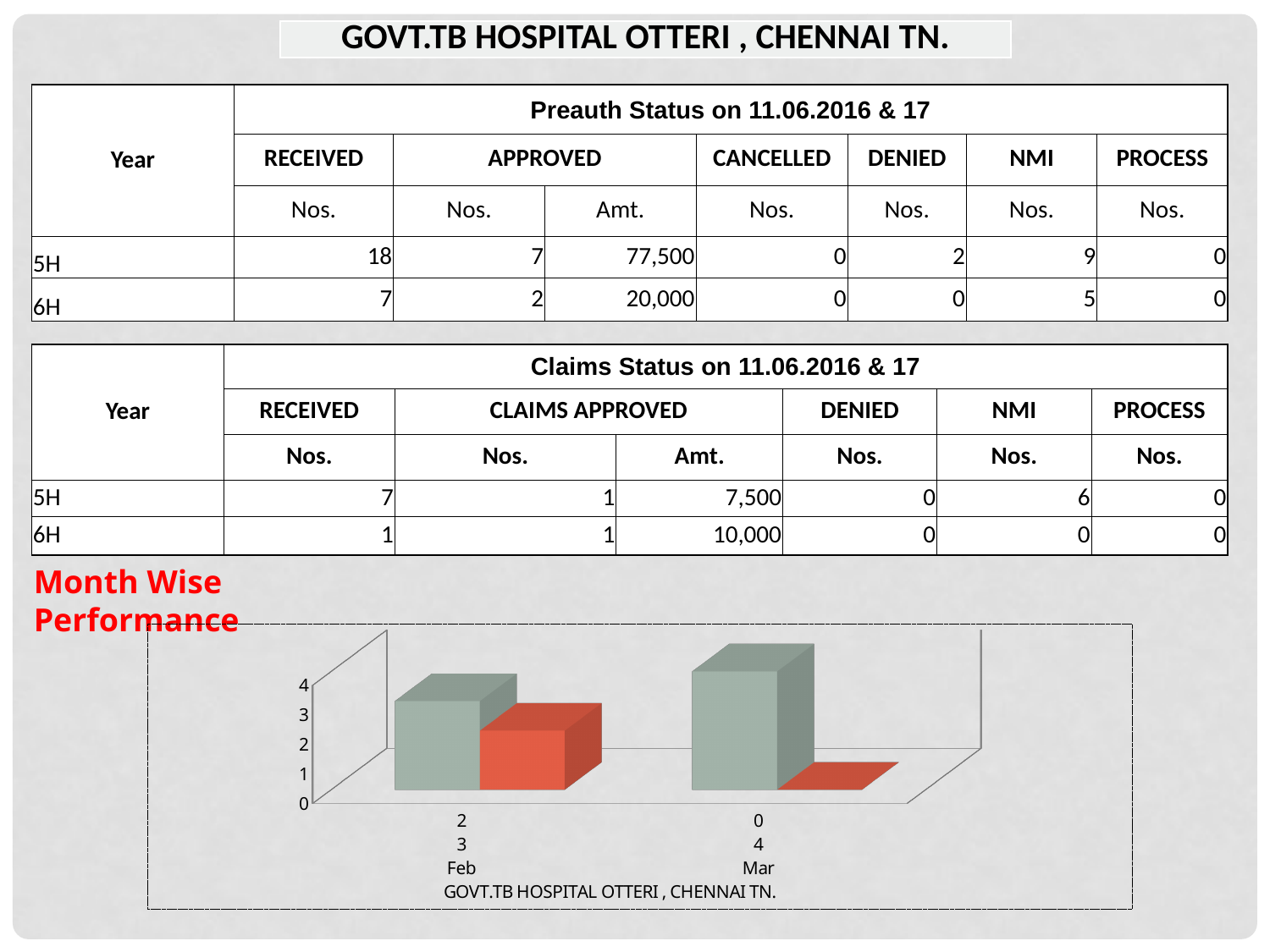
What title is printed beneath the bar chart? GOVT.TB HOSPITAL OTTERI , CHENNAI TN. In the bar chart, do the grey bars rise or fall from Feb to Mar? rise How many month categories are shown on the x axis of the bar chart? 2 In the bar chart, is the grey bar for Feb greater or less than 1? greater In the bar chart, do the red bars rise or fall from Feb to Mar? fall In the bar chart, which month has the taller red bar, Feb or Mar? Feb Which months are labelled on the x axis of the bar chart? Feb and Mar In the bar chart, which month has the taller grey bar, Feb or Mar? Mar In the bar chart, for Feb, which bar is taller, the grey one or the red one? the grey one In the bar chart, is the red bar for Feb greater or less than 3? less What kind of chart is shown under the heading 'Month Wise Performance'? bar chart In the bar chart, is the grey bar for Mar greater or less than 2? greater